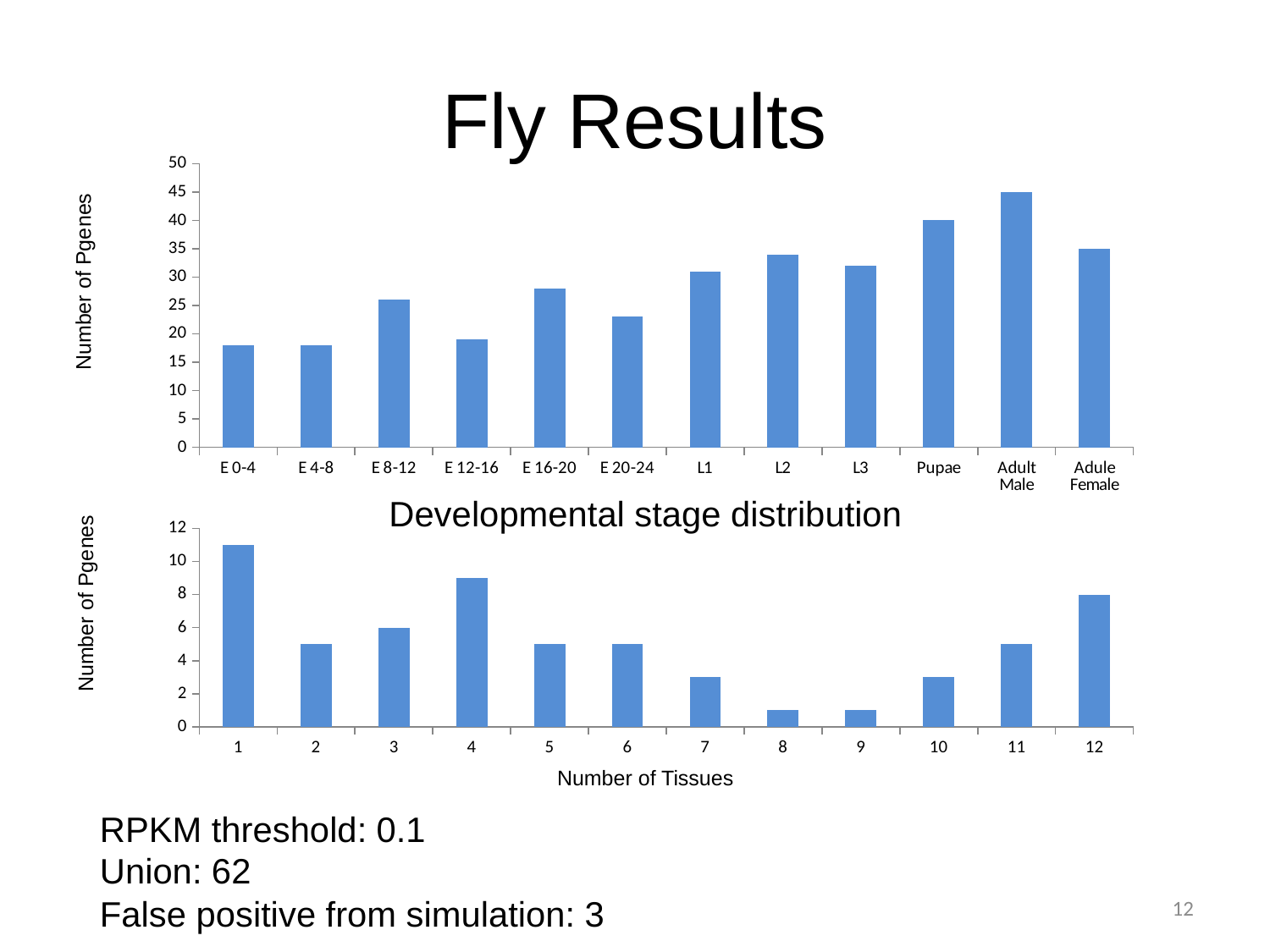
What kind of chart is the top chart on the slide? bar chart In the top chart, is the value for Pupae greater or less than 35? greater How many categories are shown on the x axis of the top chart? 12 What is the x-axis label of the bottom chart? Number of Tissues In the bottom chart, is the value for 8 tissues greater or less than 2? less In the top chart, which is larger, the value for L2 or the value for E 20-24? L2 In the top chart, which category has the highest number of Pgenes? Adult Male In the bottom chart, is the value for 1 tissue greater or less than 10? greater What is the y-axis label of the top chart? Number of Pgenes In the bottom chart, which is larger, the value for 4 tissues or the value for 7 tissues? 4 tissues In the bottom chart, which number of tissues has the highest number of Pgenes? 1